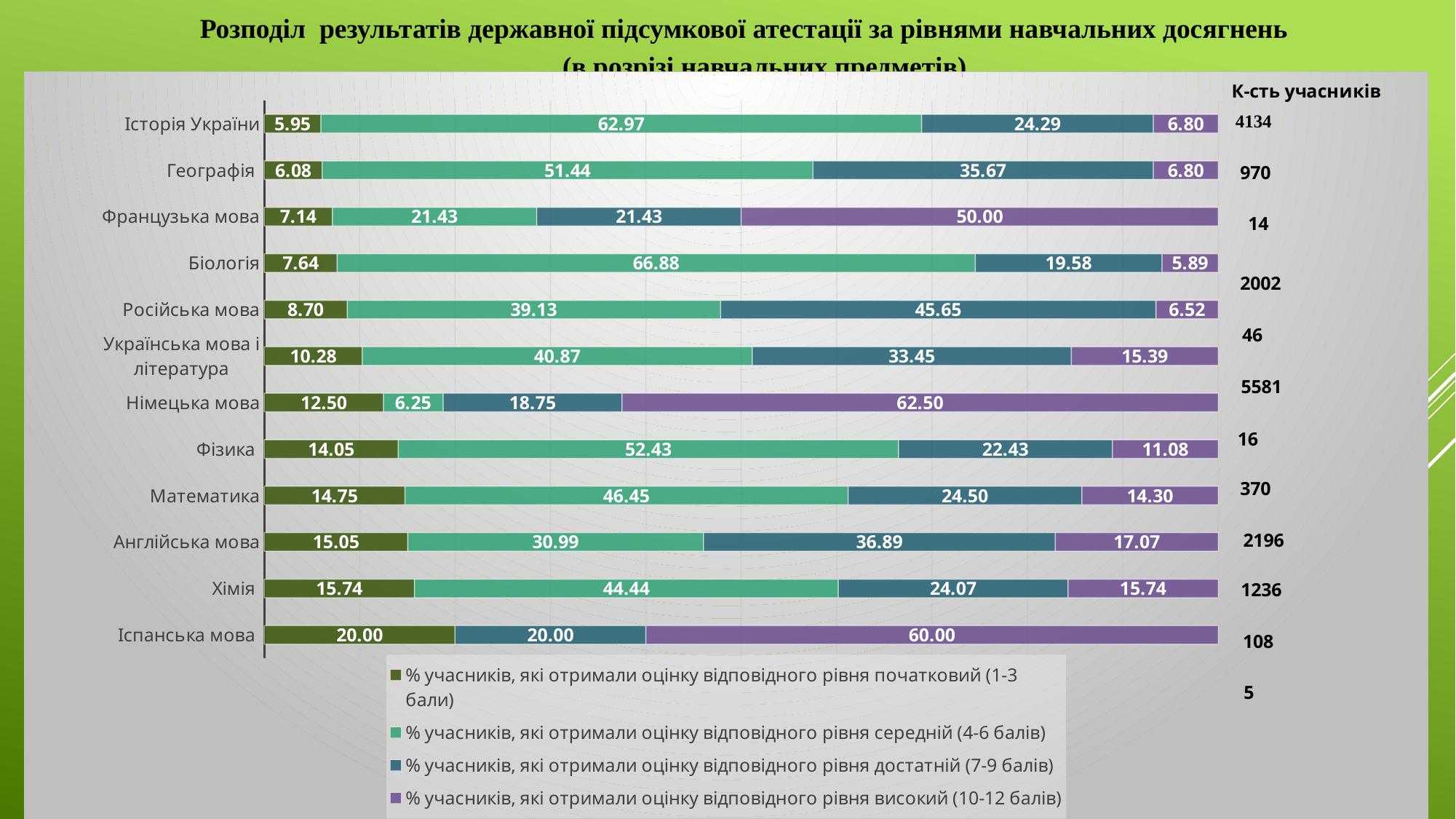
What is the value of the достатній (7-9 балів) segment for Англійська мова? 36.89 What kind of chart is shown on the slide? stacked bar chart How many subjects (categories) are plotted in the chart? 12 What is the value of the середній (4-6 балів) segment for Біологія? 66.88 What is the total of the stacked bar for Французька мова? 100.00 How many series does the legend list? 4 Which subject has the highest value for the початковий (1-3 бали) level? Іспанська мова What colour represents the високий (10-12 балів) level in the legend? purple Which subject has the lowest value for the початковий (1-3 бали) level? Історія України What is the value of the високий (10-12 балів) segment for Німецька мова? 62.50 What is the difference between the середній and достатній segments for Історія України? 38.68 For Російська мова, which is larger: the середній segment or the достатній segment? достатній